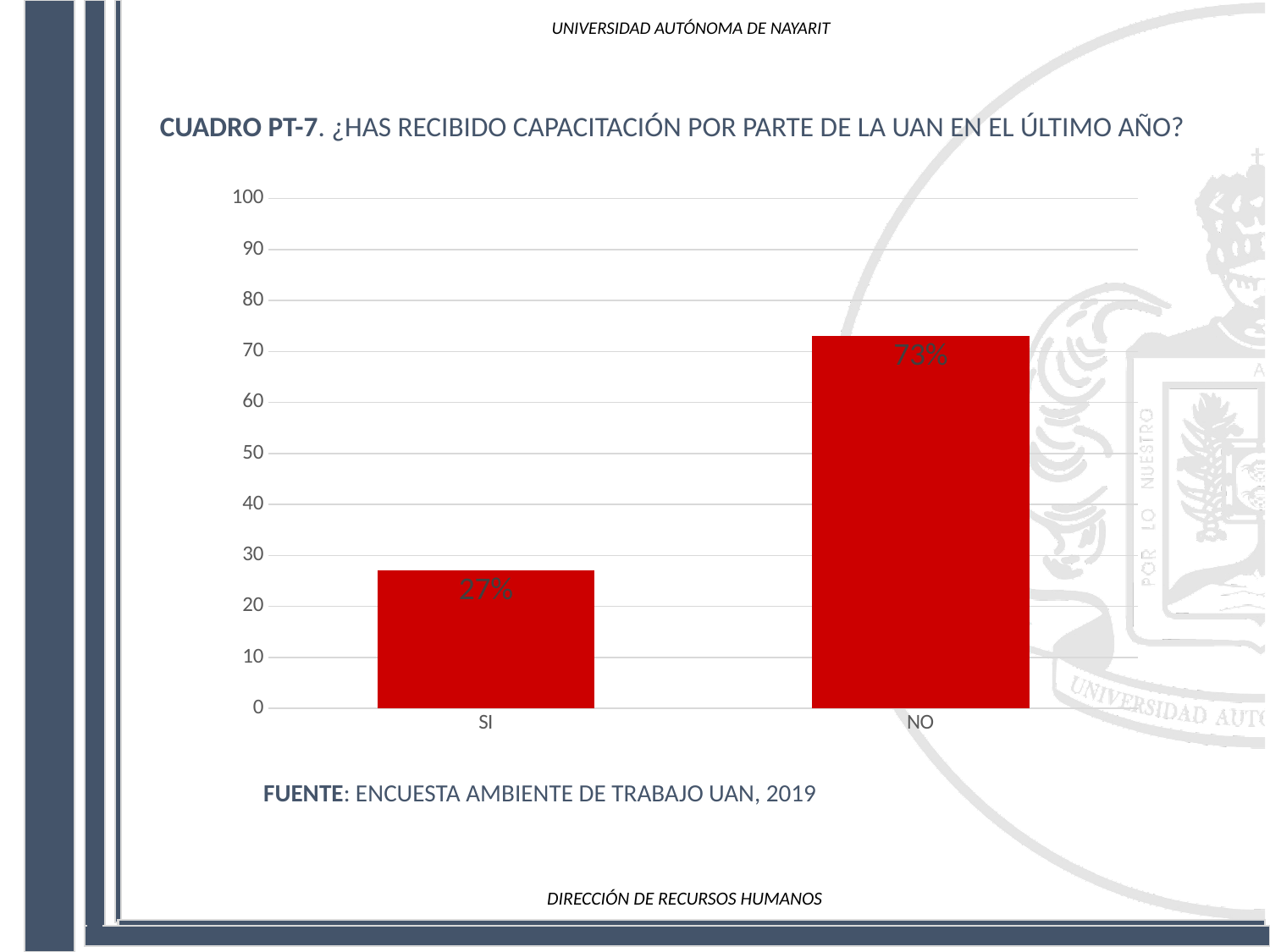
Which category has the highest value? NO Is the value for SI greater or less than 30? less Which category has the lowest value? SI How many categories are shown on the x axis? 2 What colour are the bars in the chart? red What is the value for NO? 73% Which is larger, the value for SI or the value for NO? NO What kind of chart is shown on the slide? bar chart What is the maximum value shown on the vertical axis? 100 Is the value for NO greater or less than 70? greater What is the difference between the values for NO and SI? 46% What is the value for SI? 27%